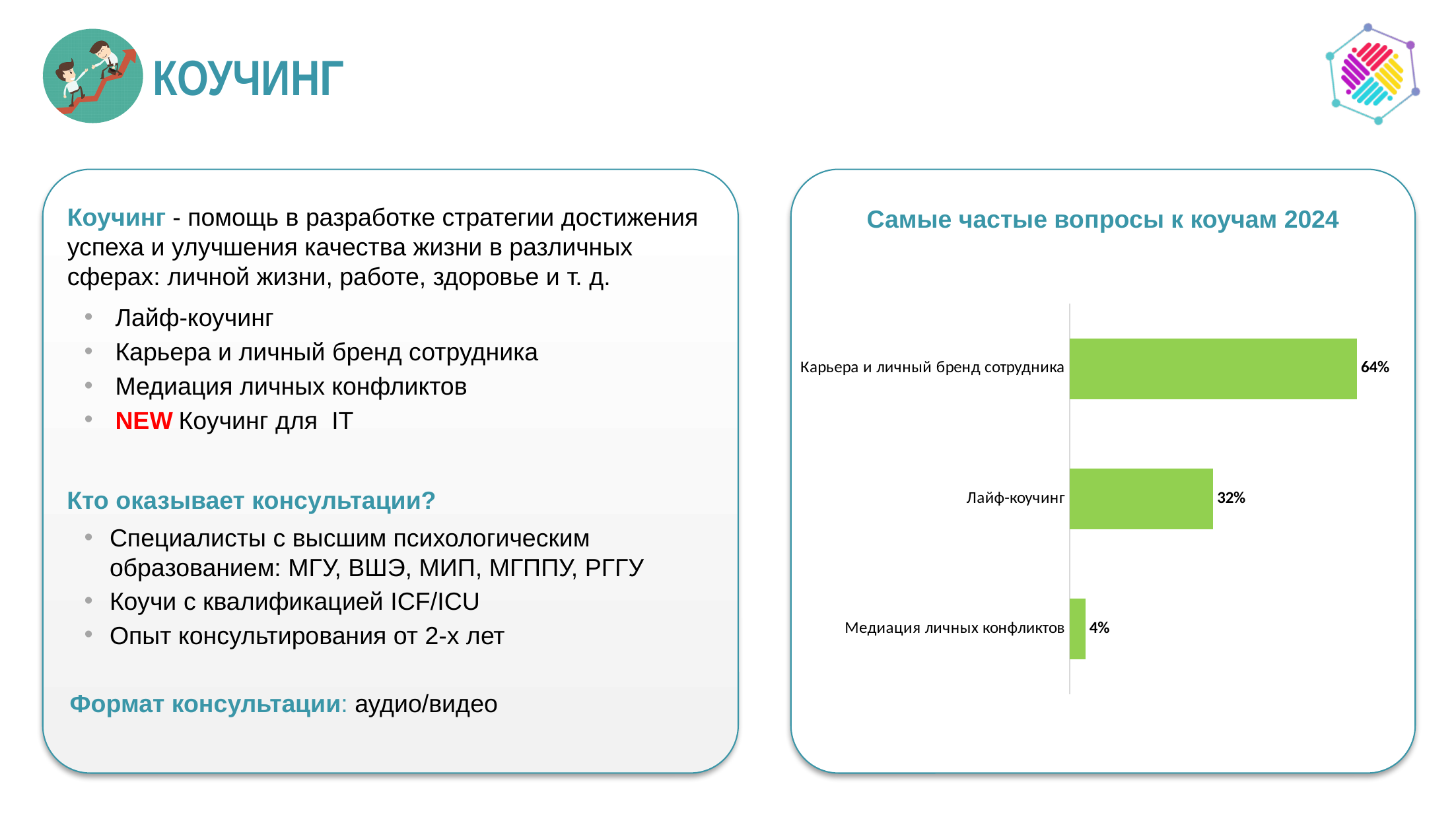
What is the title of the chart? Самые частые вопросы к коучам 2024 What is the difference between the values for Лайф-коучинг and Медиация личных конфликтов? 28% Which category has the lowest value? Медиация личных конфликтов What is the value for Лайф-коучинг? 32% What is the difference between the values for Карьера и личный бренд сотрудника and Лайф-коучинг? 32% What is the value for Медиация личных конфликтов? 4% What is the value for Карьера и личный бренд сотрудника? 64% Which category has the highest value? Карьера и личный бренд сотрудника Which is larger, the value for Лайф-коучинг or the value for Медиация личных конфликтов? Лайф-коучинг What colour are the bars in the chart? green What kind of chart is shown on the slide? bar chart How many categories are shown in the chart? 3